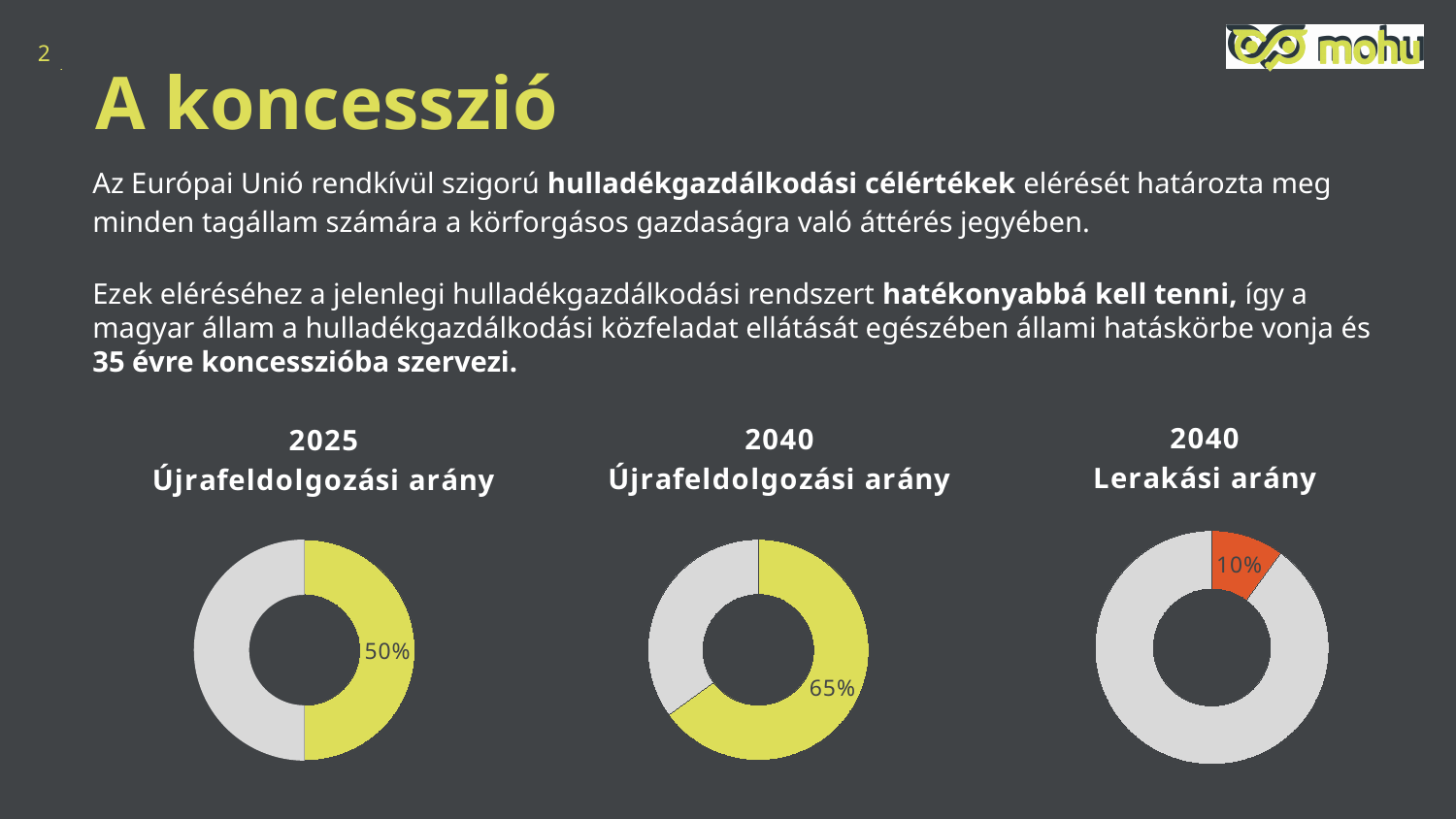
In the chart titled "2040 Újrafeldolgozási arány", what percentage is shown on the highlighted slice? 65% Which is larger: the highlighted value in the "2040 Újrafeldolgozási arány" chart or in the "2025 Újrafeldolgozási arány" chart? 2040 Újrafeldolgozási arány Is the highlighted value in the "2040 Újrafeldolgozási arány" chart greater or less than 50%? greater What colour is the highlighted slice in the "2025 Újrafeldolgozási arány" chart? Yellow What is the difference between the highlighted value in the "2040 Újrafeldolgozási arány" chart and the "2025 Újrafeldolgozási arány" chart? 15 percentage points In the chart titled "2025 Újrafeldolgozási arány", what percentage is shown on the highlighted slice? 50% What colour is the highlighted slice in the "2040 Lerakási arány" chart? Orange Among the three donut charts, which one shows the largest highlighted value? 2040 Újrafeldolgozási arány Among the three donut charts, which one shows the smallest highlighted value? 2040 Lerakási arány In the chart titled "2040 Lerakási arány", what percentage is shown on the highlighted slice? 10% How many donut charts are shown on the slide? 3 What kind of chart is used for "2025 Újrafeldolgozási arány"? Donut chart